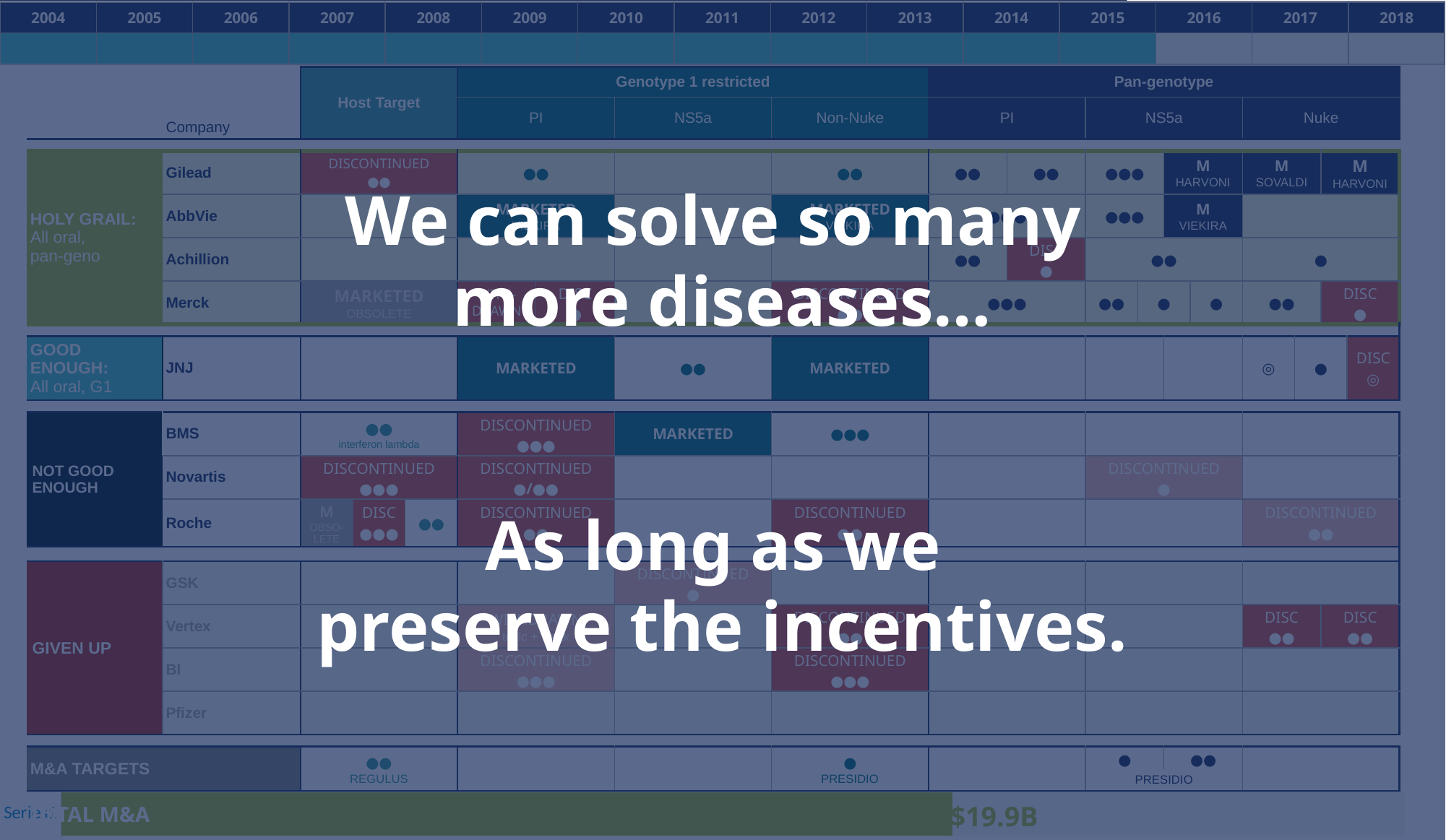
How many year labels are shown along the timeline at the top of the slide? 15 In the bar at the bottom of the slide, what value is printed for TOTAL M&A? $19.9B How many bars are plotted in the TOTAL M&A chart at the bottom of the slide? 1 In the timeline bar at the top of the slide, through which year does the teal filled segment extend? 2015 What kind of chart is the TOTAL M&A graphic at the bottom of the slide? bar chart What series name is shown at the left of the TOTAL M&A bar at the bottom of the slide? Series1 In the timeline bar at the top of the slide, what is the first year shown on the axis? 2004 In the timeline bar at the top of the slide, what is the last year shown on the axis? 2018